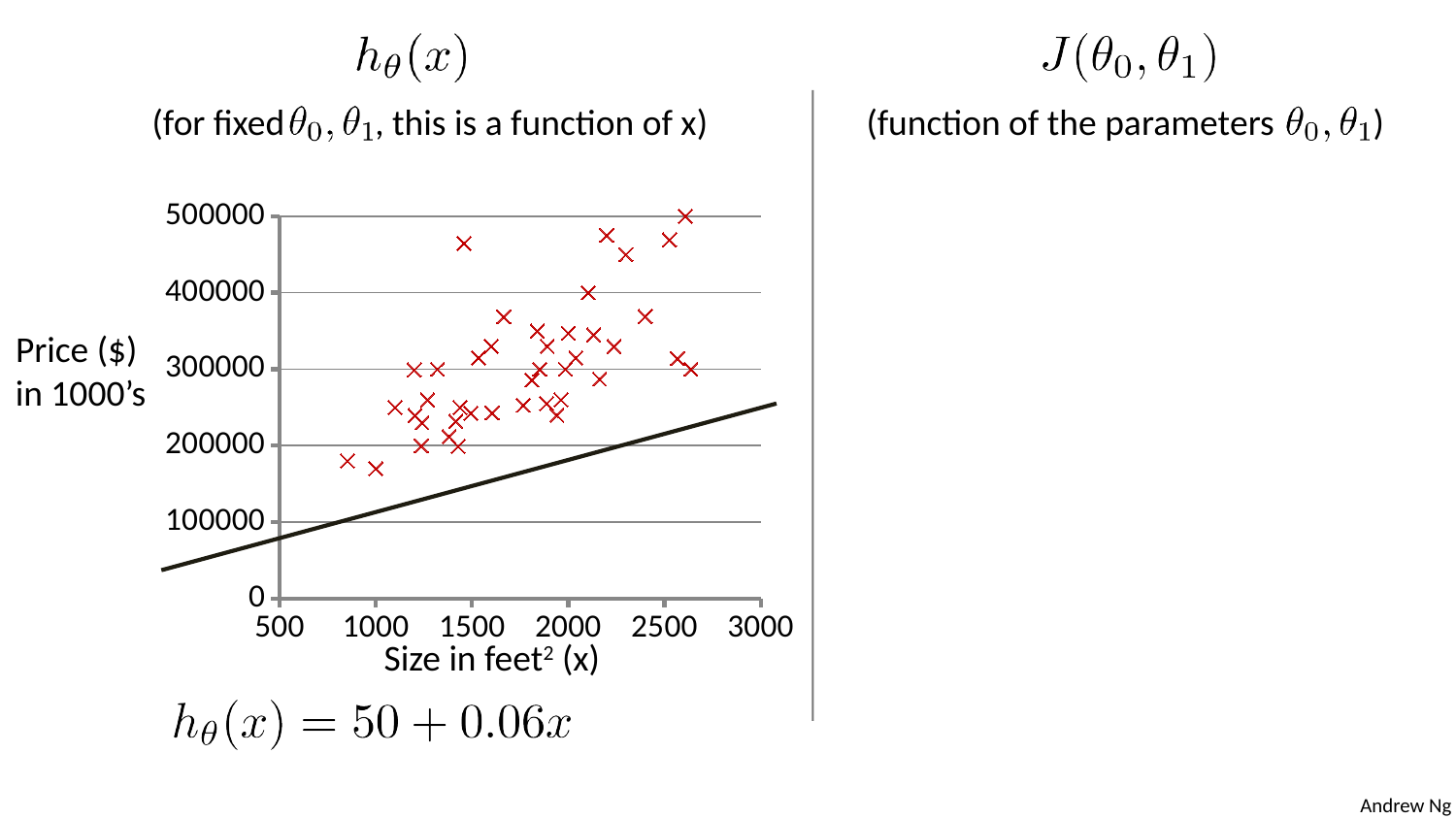
What is the highest value shown on the x axis of the chart? 3000 What is the lowest value shown on the x axis of the chart? 500 Is the highest plotted data point greater or less than 400000? greater What kind of chart is shown on the slide? scatter chart What is the label of the x axis of the chart? Size in feet² (x) Is the value of the fitted line at x = 500 greater or less than 100000? less What is the label of the y axis of the chart? Price ($) in 1000's Do the plotted prices generally rise or fall as size increases along the x axis? rise Is the lowest plotted data point greater or less than 200000? less What is the highest value shown on the y axis of the chart? 500000 What equation for the hypothesis is written below the chart? hθ(x) = 50 + 0.06x